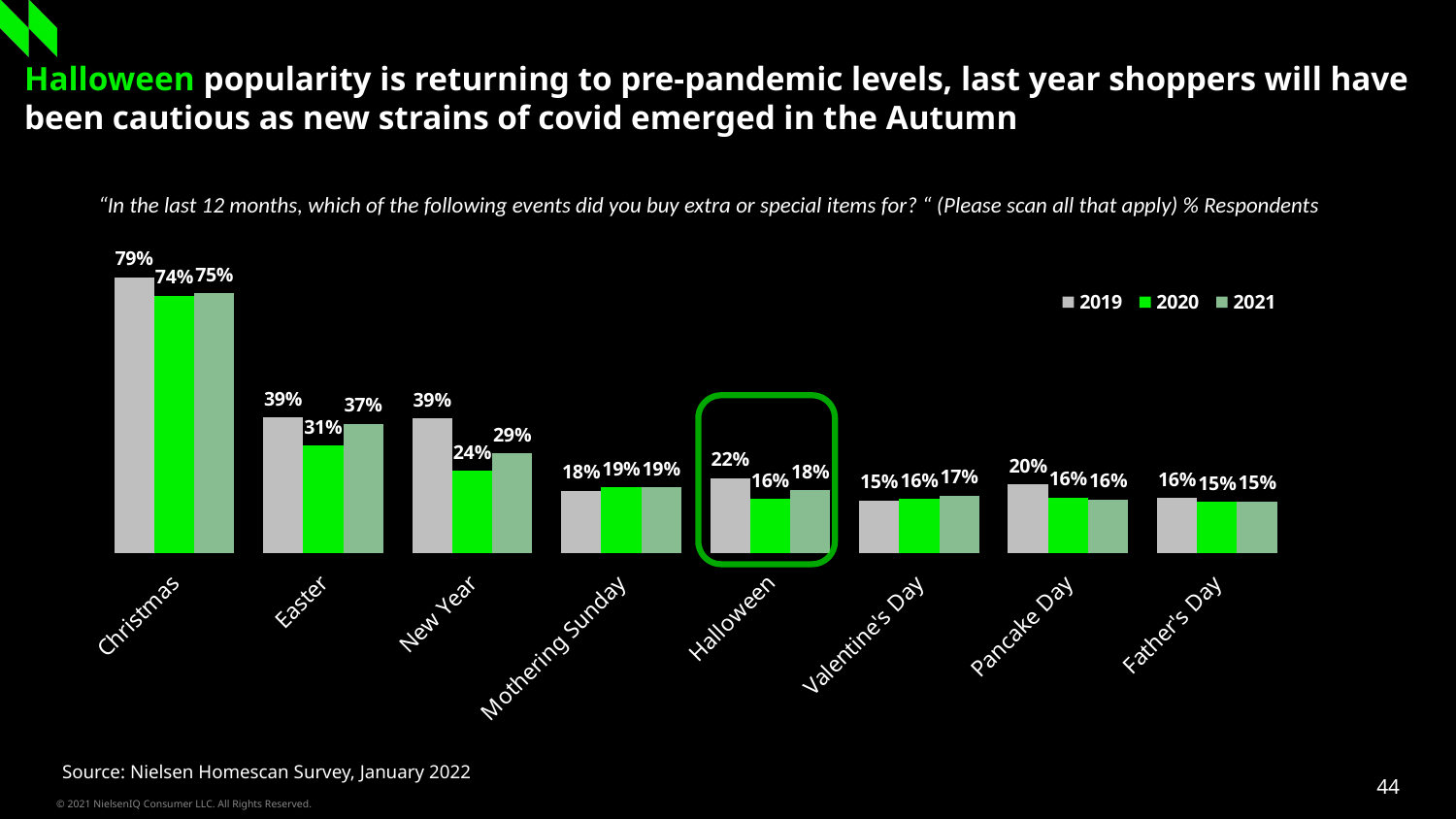
Which event is highlighted with a green outline on the chart? Halloween What percentage of respondents bought extra or special items for Halloween in 2021? 18% What is the difference between the Christmas and Easter values in 2021? 38% What is the difference between the 2019 and 2020 values for New Year? 15% Which event had the lowest percentage of respondents in 2020? Father's Day How many series does the legend list? 3 Which is larger: the 2021 value for Easter or the 2021 value for New Year? Easter What was the value for Easter in 2020? 31% Which event had the highest percentage of respondents in 2019? Christmas What kind of chart is shown on the slide? Bar chart What was the value for Pancake Day in 2019? 20% How many events are shown on the x axis of the chart? 8